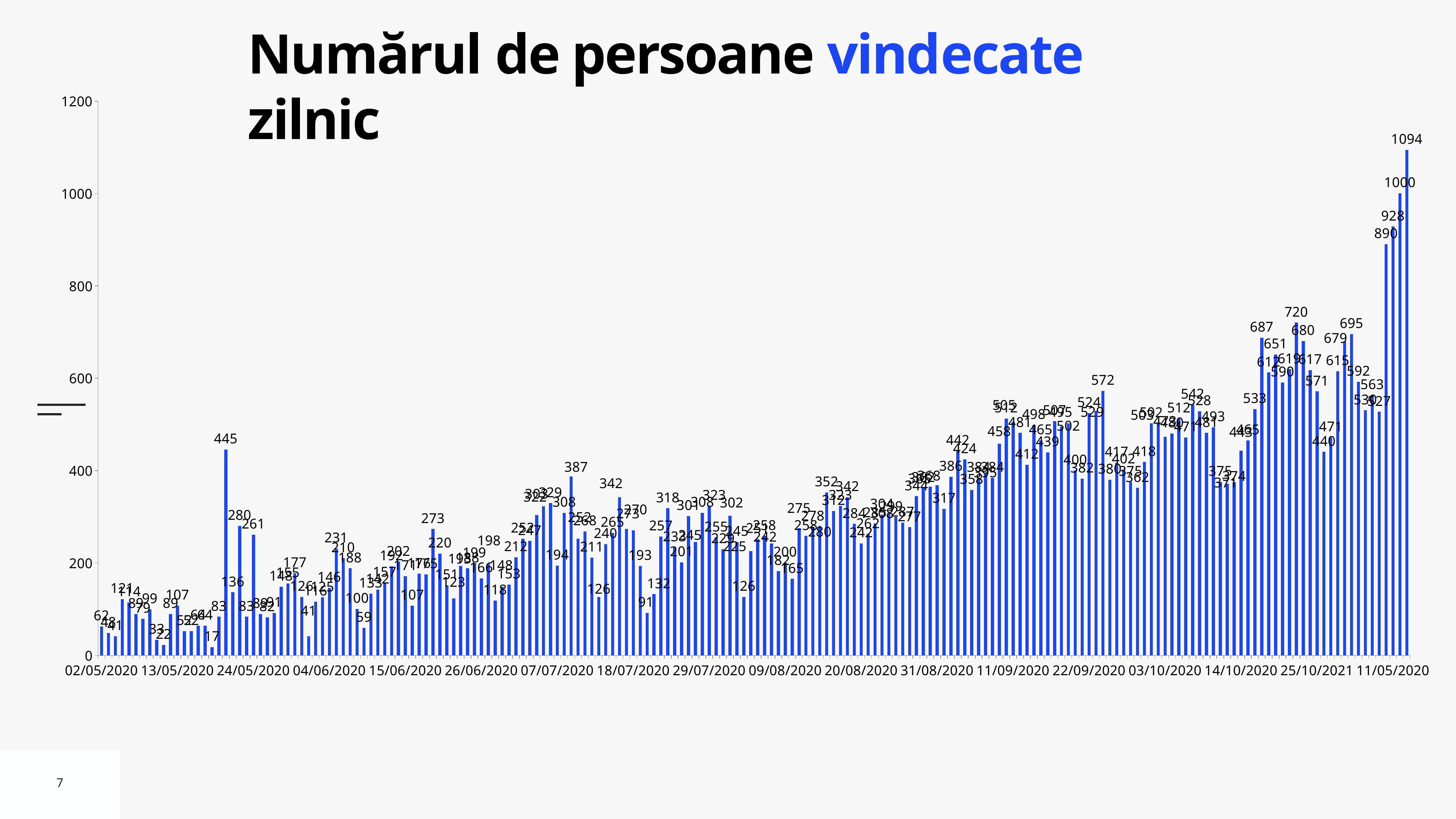
What is the lowest value labelled on the chart? 17 Which is larger, the bar labelled 445 in May or the bar labelled 387 in July? 445 What is the difference between the two highest labelled values, 1094 and 1000? 94 What is the title of the chart? Numărul de persoane vindecate zilnic Is the value for the first bar (02/05/2020) greater or less than 200? less Overall, do the values rise or fall from left to right along the x axis? rise Is the value for the last bar (11/05/2020) greater or less than 1000? greater What kind of chart is shown on the slide? bar chart What is the maximum value shown on the y axis? 1200 What is the value for the first date, 02/05/2020? 62 What is the highest value shown on the chart? 1094